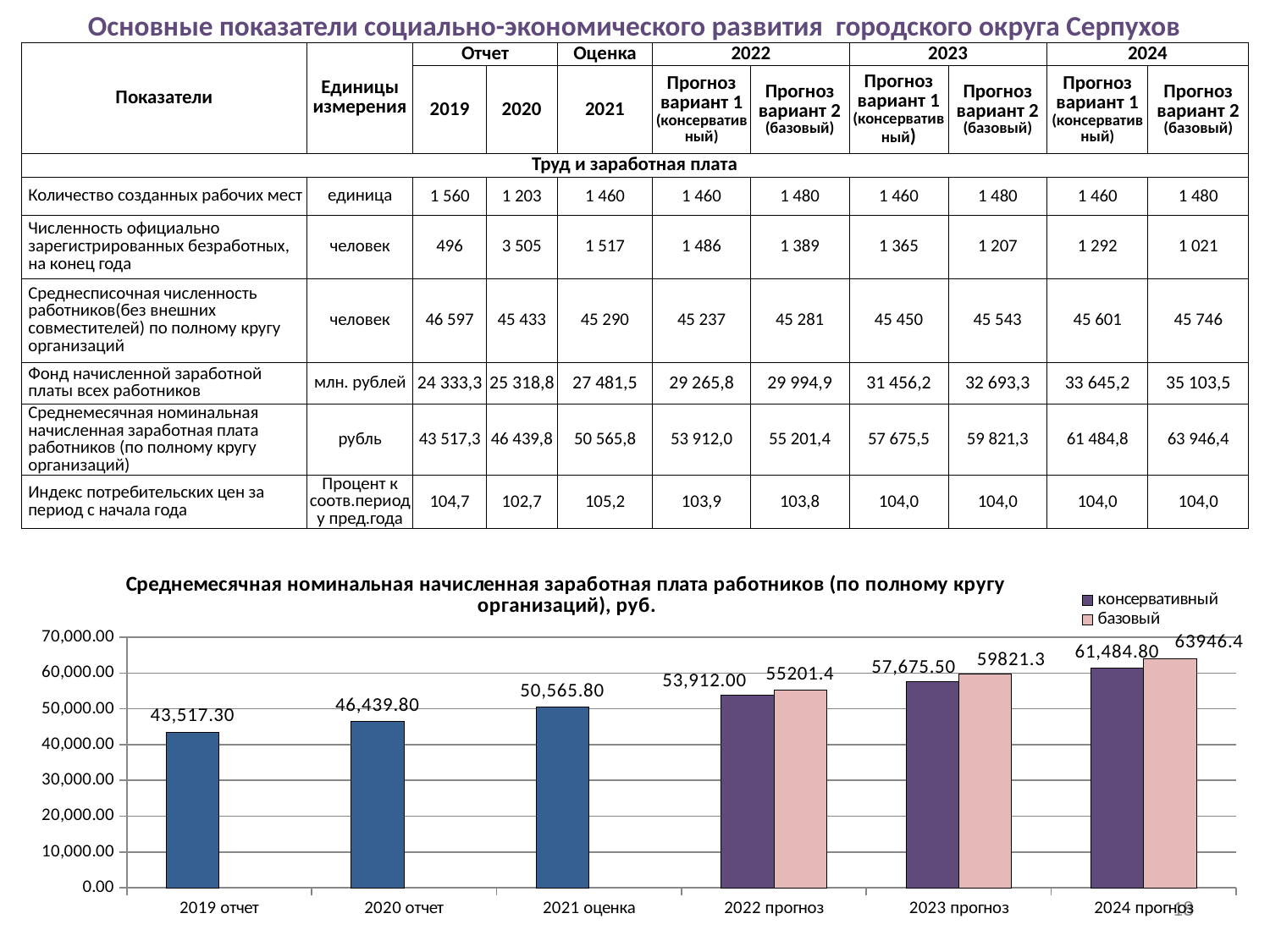
What is the базовый value for 2022 прогноз in the chart? 55201.4 What is the value for 2019 отчет in the chart? 43,517.30 What is the value for 2021 оценка in the chart? 50,565.80 What type of chart is shown on the slide? bar chart How many categories are shown on the x axis of the chart? 6 What is the консервативный value for 2024 прогноз in the chart? 61,484.80 Do the values in the chart rise or fall from 2019 отчет to 2024 прогноз? rise How many series does the chart legend list? 2 Which category has the highest value in the chart? 2024 прогноз What is the difference between the базовый and консервативный values for 2023 прогноз? 2145.8 Which category has the lowest value in the chart? 2019 отчет Which is larger for 2022 прогноз: the консервативный value or the базовый value? базовый